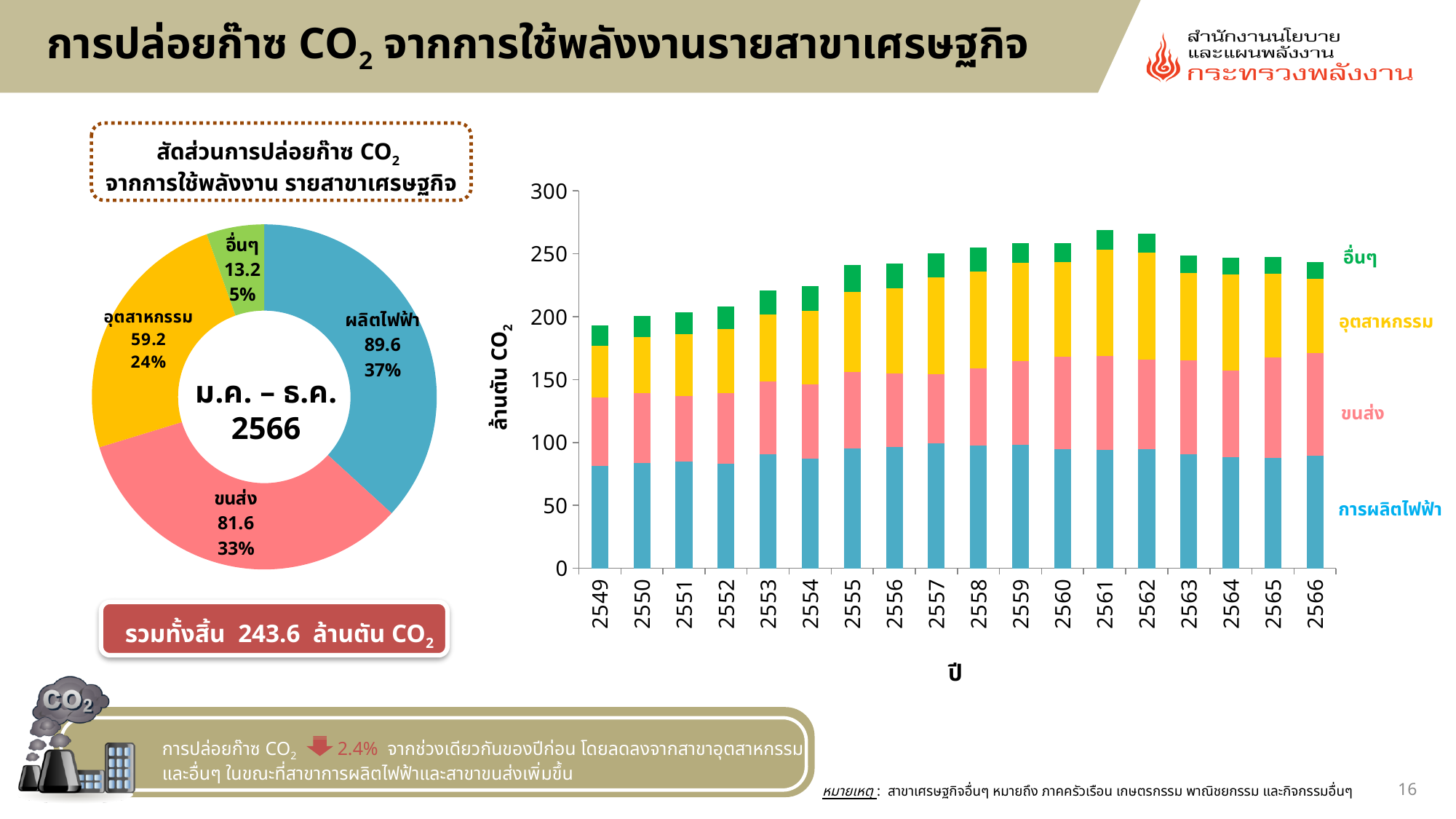
On the pie chart on the left, what share of the total does ขนส่ง account for? 33% On the pie chart on the left, which category has the smallest share? อื่นๆ On the bar chart on the right, how many series are stacked in each bar? 4 On the bar chart on the right, is the total for 2549 greater or less than 200? less On the pie chart on the left, what is the difference between the values for ผลิตไฟฟ้า and ขนส่ง? 8.0 What kind of chart is the chart on the right of the slide? Stacked bar chart On the pie chart on the left, which category has the largest share? ผลิตไฟฟ้า On the bar chart on the right, how many years are shown on the x axis? 18 On the bar chart on the right, is the total for 2561 greater or less than 250? greater On the pie chart on the left, what is the value for ผลิตไฟฟ้า? 89.6 On the pie chart on the left, what is the value for อุตสาหกรรม? 59.2 On the pie chart on the left, how many categories are shown? 4